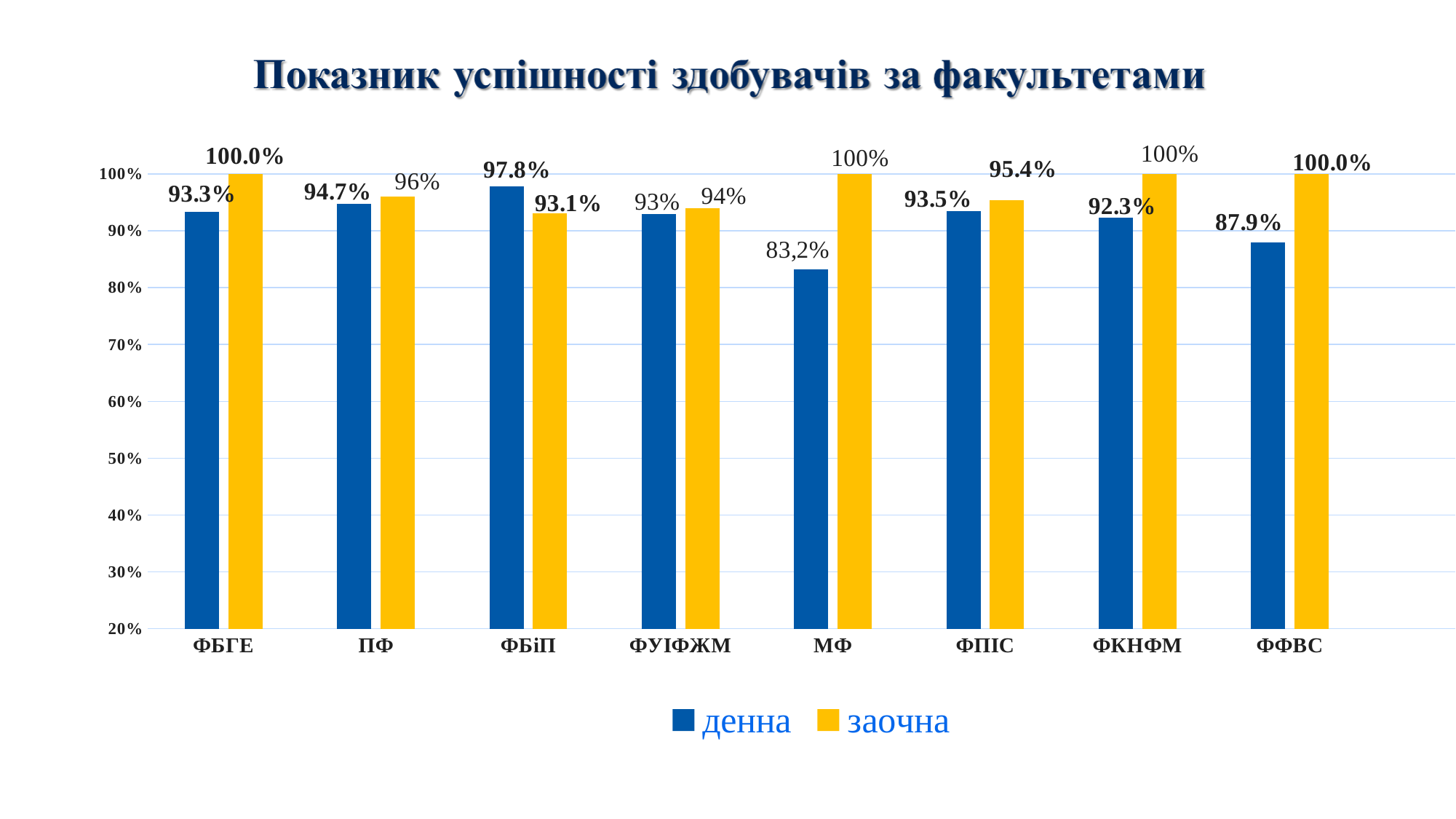
How many faculties are shown on the x axis? 8 Is the денна value for ФФВС greater or less than 90%? less How many series does the legend list? 2 For ФБіП, which is larger: the денна value or the заочна value? денна What is the difference between the заочна and денна values for МФ? 16.8 percentage points Which faculty has the lowest заочна value? ФБіП What kind of chart is shown on the slide? bar chart What is the денна value for ФБіП? 97.8% What is the заочна value for ПФ? 96% Which faculty has the lowest денна value? МФ What is the денна value for МФ? 83,2% Which faculty has the highest денна value? ФБіП